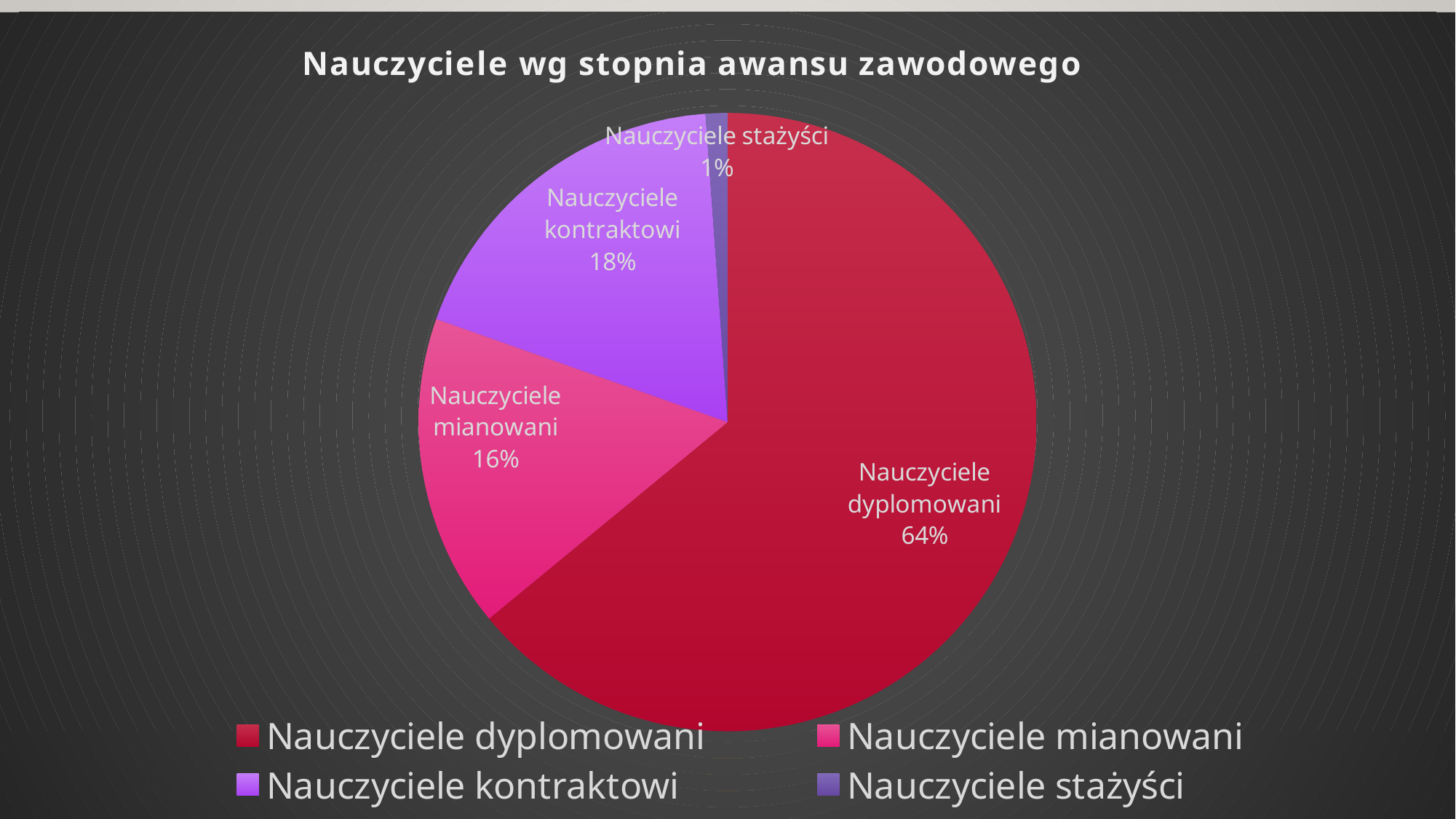
Which is larger, the share for Nauczyciele kontraktowi or Nauczyciele mianowani? Nauczyciele kontraktowi What share of the pie is Nauczyciele mianowani? 16% Which category has the largest slice of the pie? Nauczyciele dyplomowani What is the title of the chart? Nauczyciele wg stopnia awansu zawodowego What share of the pie is Nauczyciele dyplomowani? 64% How many categories are shown in the pie chart? 4 What is the difference in percentage points between Nauczyciele dyplomowani and Nauczyciele kontraktowi? 46 What share of the pie is Nauczyciele kontraktowi? 18% Which category has the smallest slice of the pie? Nauczyciele stażyści What kind of chart is shown on the slide? pie chart What colour is the slice for Nauczyciele kontraktowi? purple